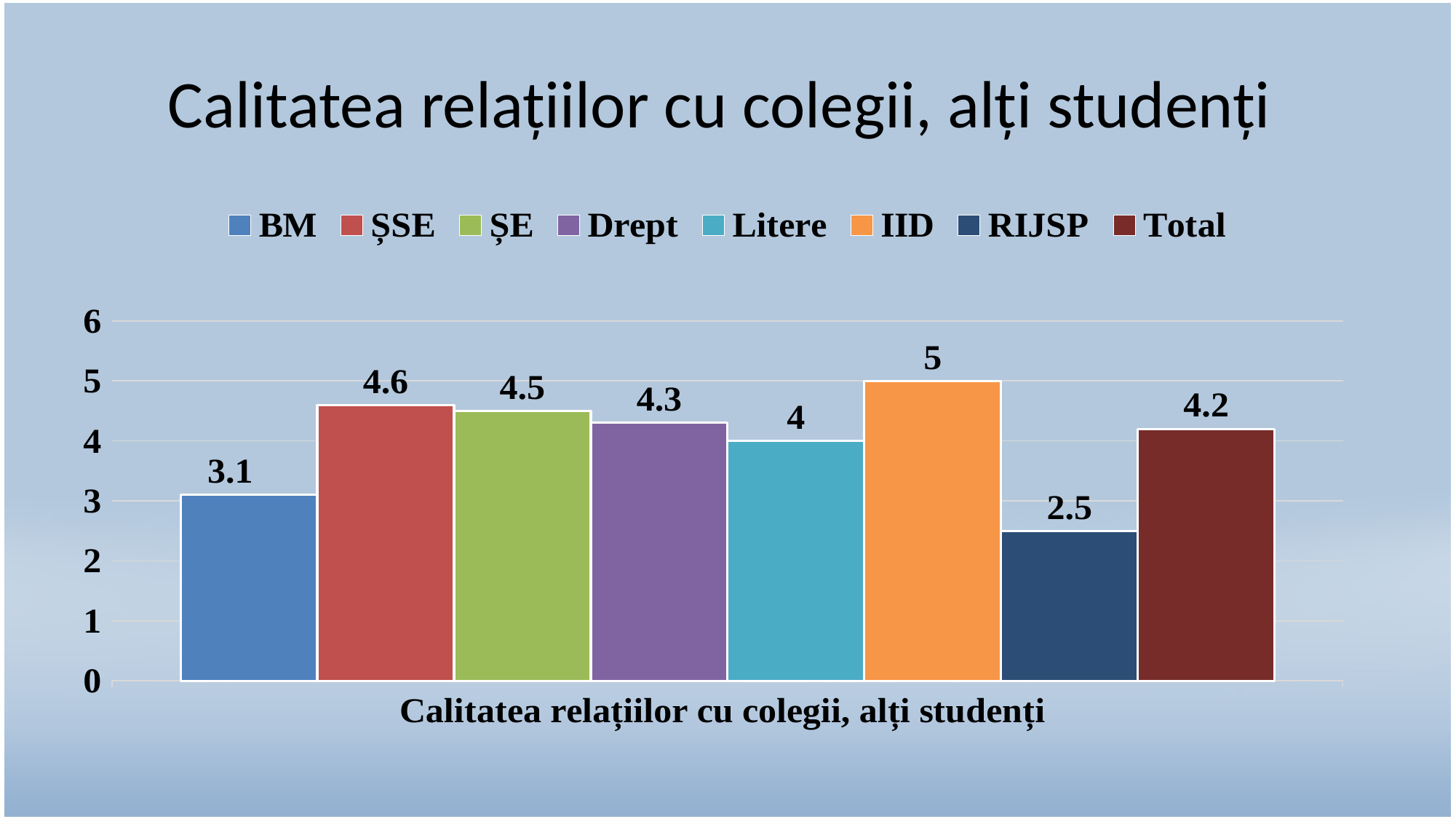
What is the title of the chart? Calitatea relațiilor cu colegii, alți studenți Which series has the highest value? IID What colour is the bar for IID? orange What is the value for IID? 5 What is the value for BM? 3.1 What is the value for Total? 4.2 What kind of chart is shown on the slide? bar chart What is the difference between the values for ȘSE and RIJSP? 2.1 How many series does the legend list? 8 Which series has the lowest value? RIJSP Is the value for RIJSP greater or less than 3? less Which is larger, the value for Drept or the value for Litere? Drept